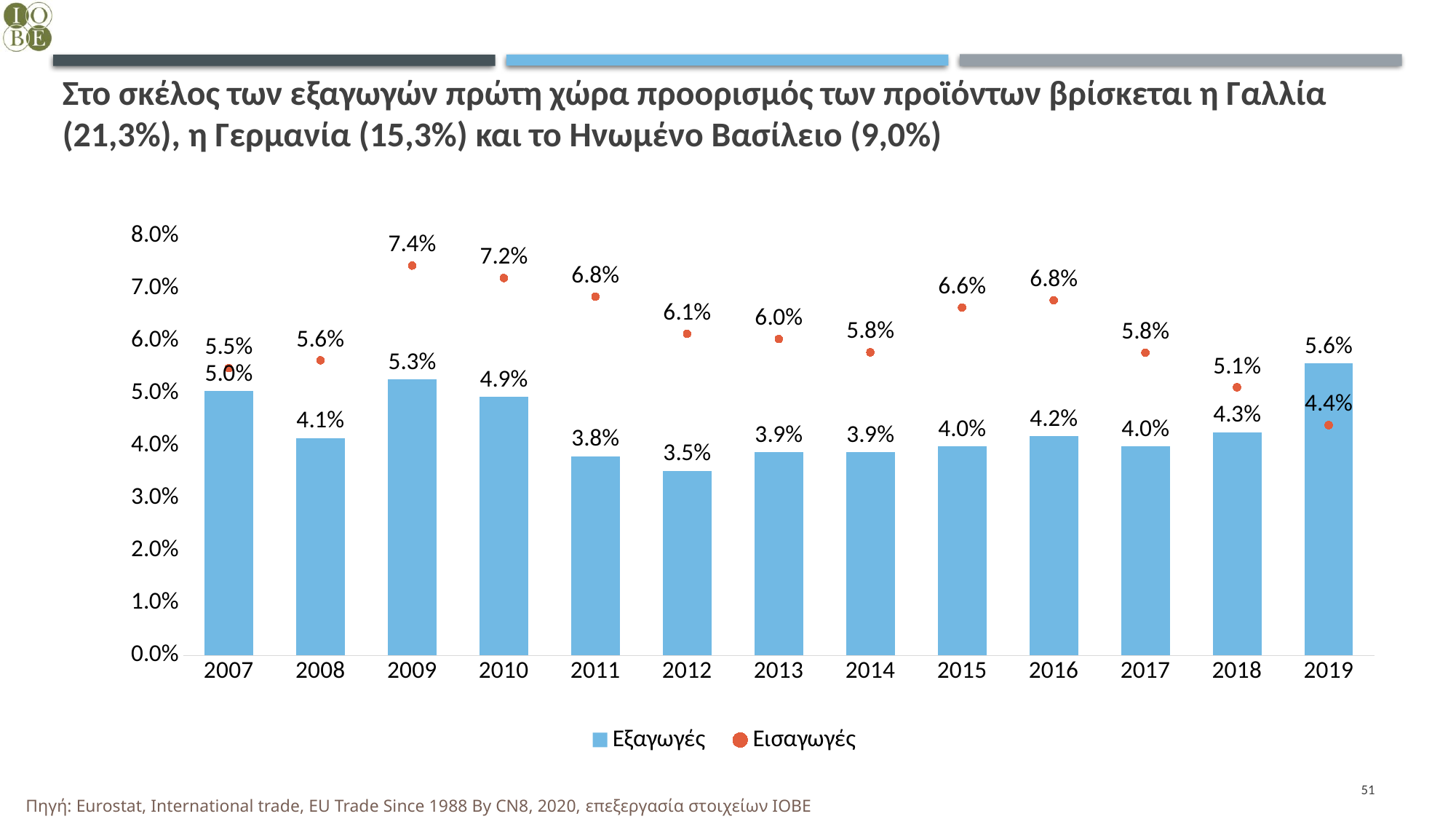
Which year has the highest Εισαγωγές value? 2009 What is the value of Εξαγωγές for 2012? 3.5% Which year has the lowest Εξαγωγές value? 2012 What is the difference between Εισαγωγές and Εξαγωγές in 2010? 2.3% What is the value of Εισαγωγές for 2009? 7.4% What colour are the Εισαγωγές markers? Orange-red How many years are shown on the x axis? 13 What is the value of Εισαγωγές for 2018? 5.1% How many series does the legend list? 2 What is the value of Εξαγωγές for 2019? 5.6% Which is larger in 2019, Εξαγωγές or Εισαγωγές? Εξαγωγές What kind of chart is used to show the Εξαγωγές series? Bar chart